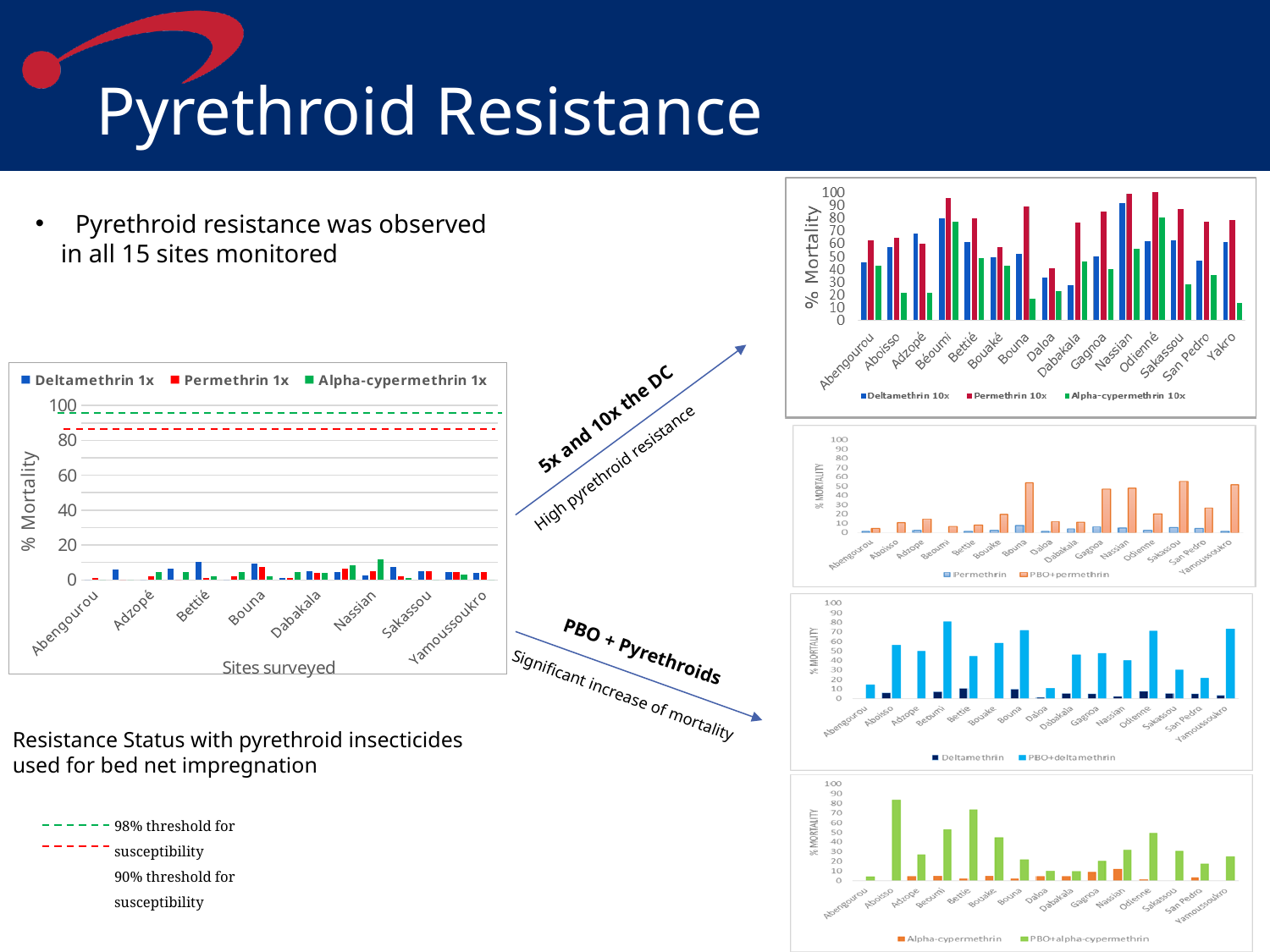
On the top-right chart (10x insecticides), which is larger for Yakro: Deltamethrin 10x or Alpha-cypermethrin 10x? Deltamethrin 10x On the second chart on the right (Permethrin and PBO+permethrin), is the PBO+permethrin value for Bouna greater or less than 40? greater On the top-right chart (10x insecticides), is the Alpha-cypermethrin 10x value for Bouna greater or less than 30? less On the bottom-right chart (Alpha-cypermethrin and PBO+alpha-cypermethrin), which site has the highest PBO+alpha-cypermethrin value? Aboisso On the third chart on the right (Deltamethrin and PBO+deltamethrin), which is larger for Aboisso: Deltamethrin or PBO+deltamethrin? PBO+deltamethrin On the chart at the bottom left (Deltamethrin 1x, Permethrin 1x, Alpha-cypermethrin 1x), how many series does the legend list? 3 On the third chart on the right (Deltamethrin and PBO+deltamethrin), is the PBO+deltamethrin value for Daloa greater or less than 20? less On the top-right chart (Deltamethrin 10x, Permethrin 10x, Alpha-cypermethrin 10x), how many sites are shown on the x axis? 15 On the bottom-left chart (1x insecticides), what is the x-axis title? Sites surveyed What kind of chart is the bottom-left chart with the Deltamethrin 1x, Permethrin 1x and Alpha-cypermethrin 1x series? Bar chart